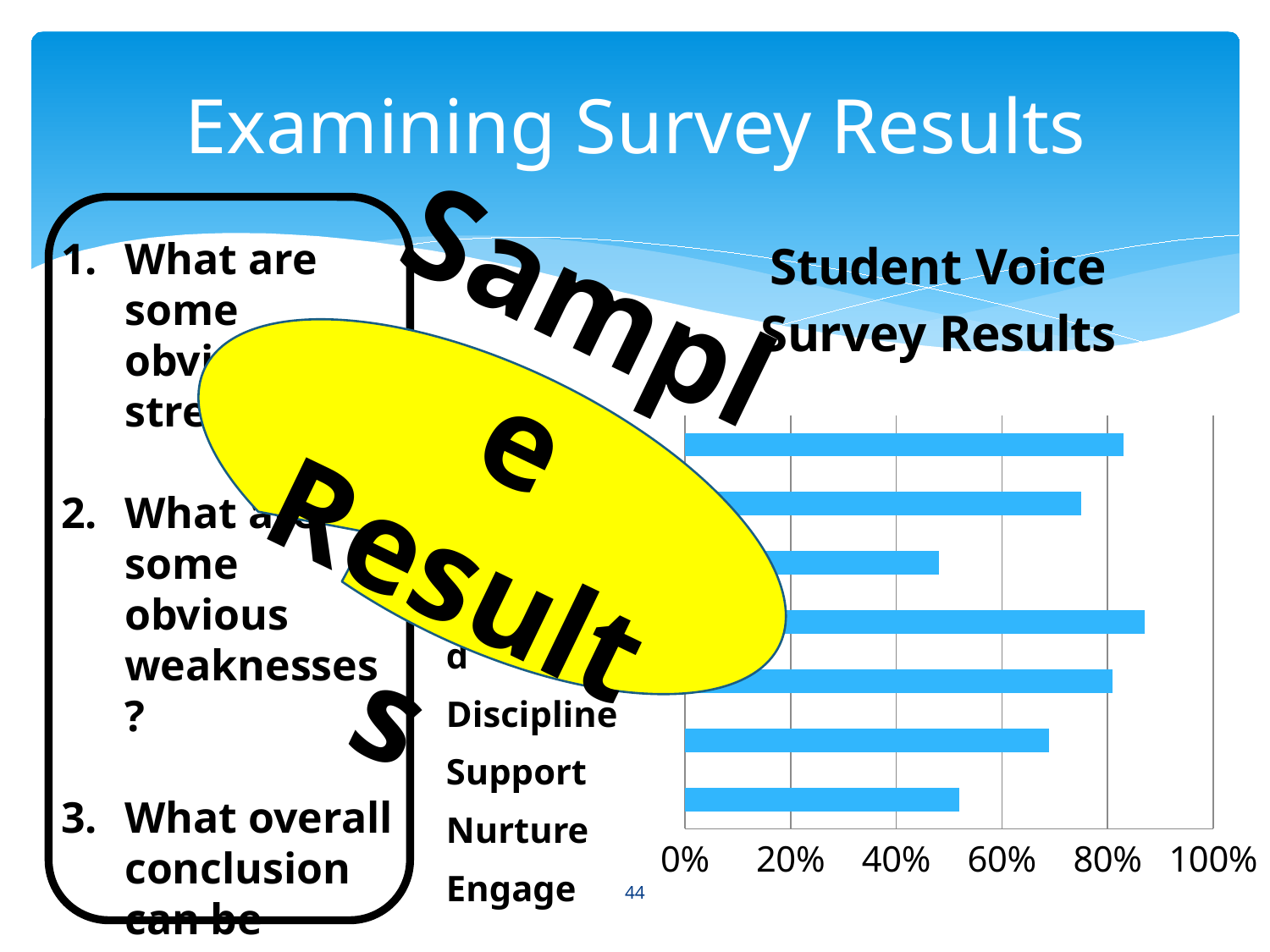
In the Student Voice Survey Results chart, is the value of the third bar from the top greater or less than 60%? less In the Student Voice Survey Results chart, is the value of the top bar greater or less than 60%? greater In the Student Voice Survey Results chart, is the value of the sixth bar from the top greater or less than 80%? less What kind of chart is shown on the slide? bar chart What is the title of the chart on the slide? Student Voice Survey Results What is the highest value shown on the horizontal axis of the Student Voice Survey Results chart? 100% How many bars are plotted in the Student Voice Survey Results chart? 7 In the Student Voice Survey Results chart, which bar is the longest: the top bar or the fourth bar from the top? the fourth bar from the top In the Student Voice Survey Results chart, which is larger: the second bar from the top or the third bar from the top? the second bar from the top